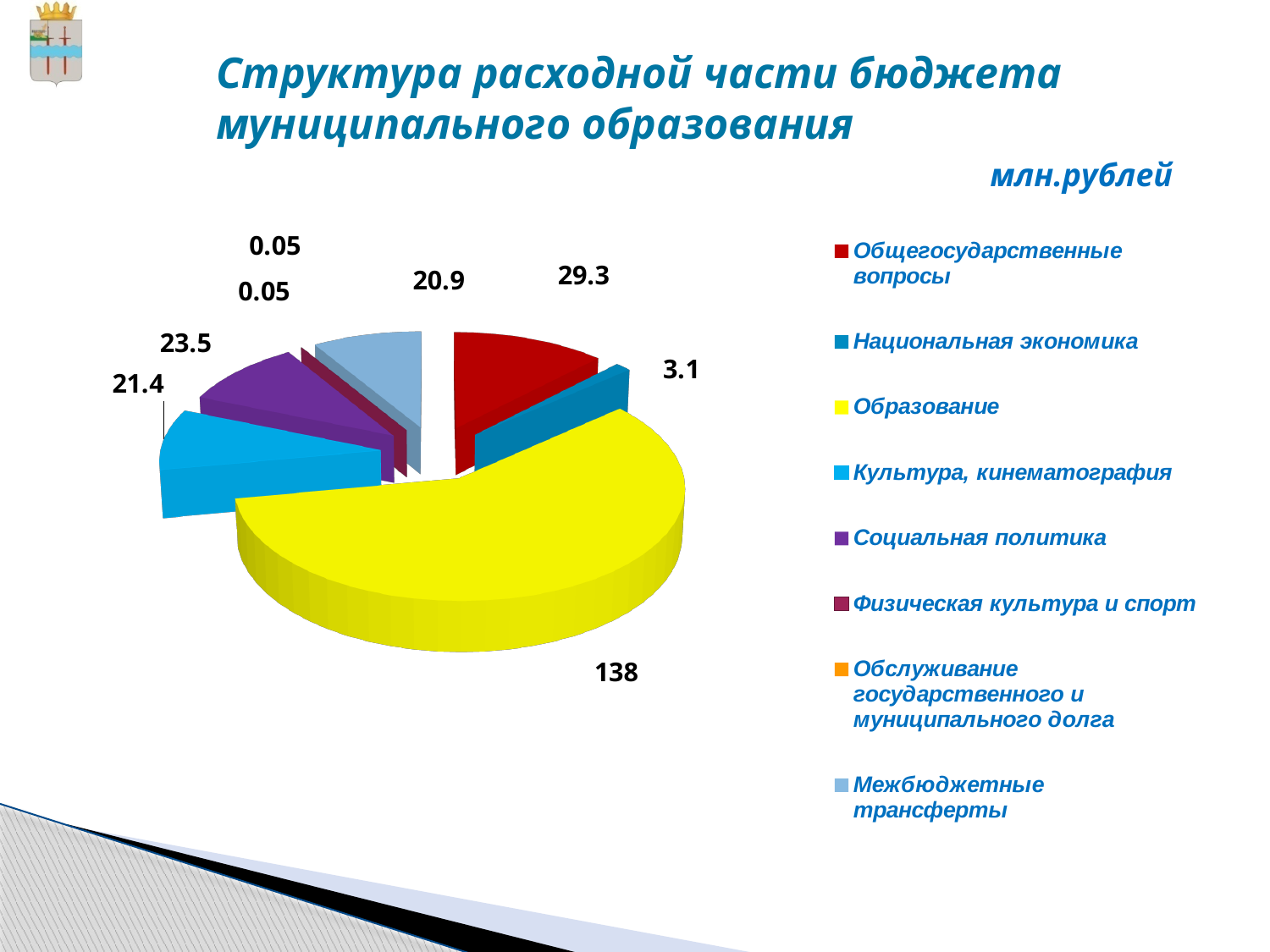
What is the value for Образование? 138 What is the value for Культура, кинематография? 21.4 How many categories does the legend list? 8 What is the difference between the values for Образование and Общегосударственные вопросы? 108.7 What is the value for Общегосударственные вопросы? 29.3 Which category has the largest slice of the pie? Образование What is the value for Межбюджетные трансферты? 20.9 Which is larger, the value for Социальная политика or the value for Культура, кинематография? Социальная политика What is the difference between the values for Социальная политика and Культура, кинематография? 2.1 What is the value for Национальная экономика? 3.1 What type of chart is shown on the slide? pie chart What unit is stated for the values on the slide? млн.рублей